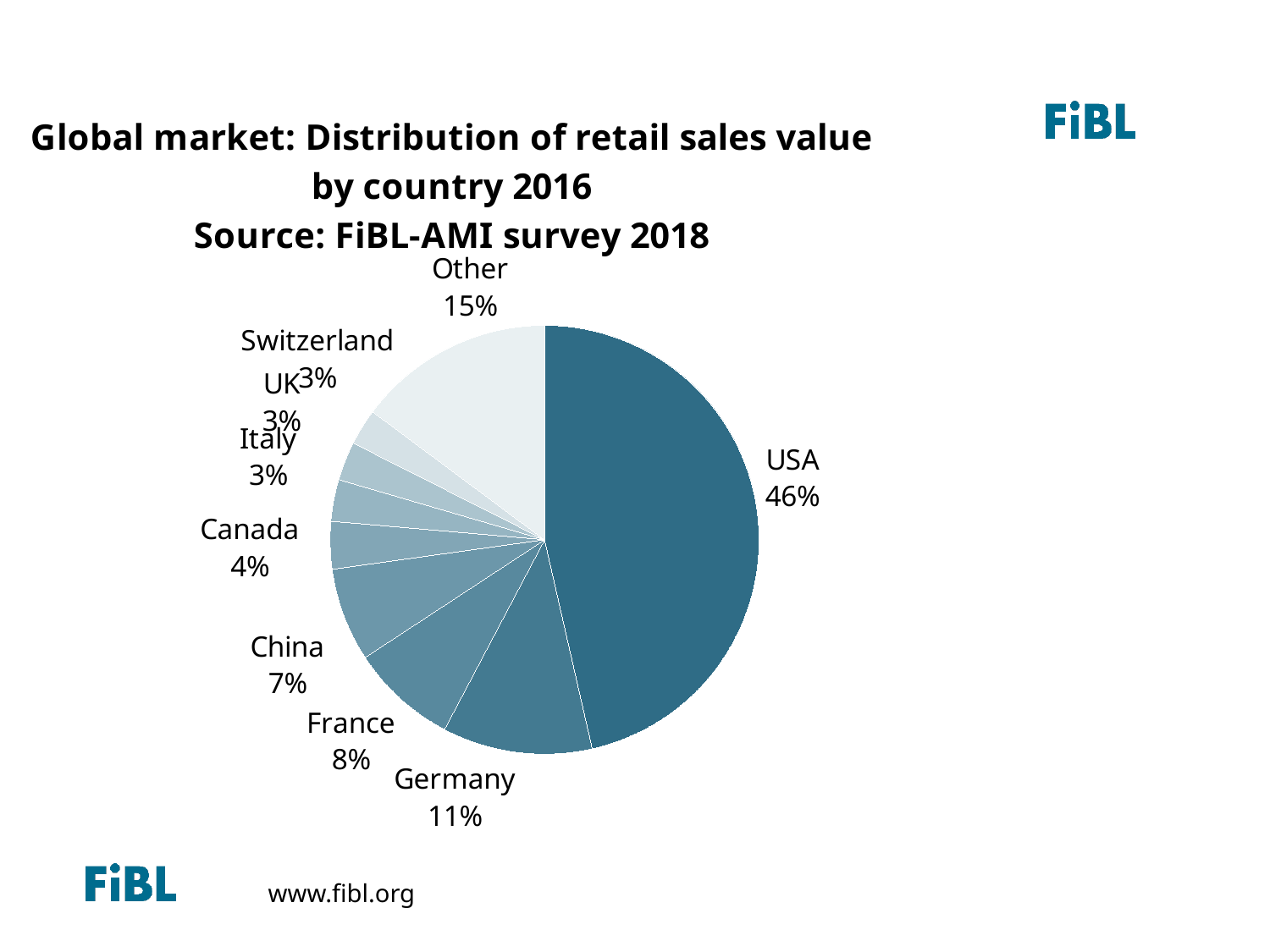
What share of retail sales value does the USA hold? 46% What is the combined share of Germany and France? 19% What percentage is shown for Switzerland? 3% Which has a larger share, France or Canada? France What kind of chart is shown on the slide? Pie chart What percentage is shown for China? 7% Which country has the largest share of retail sales value? USA What is the difference in percentage points between the USA and Germany? 35 What percentage is shown for Germany? 11% What is the value for the 'Other' slice? 15% How many slices does the pie chart have? 9 What source is cited in the chart title? FiBL-AMI survey 2018